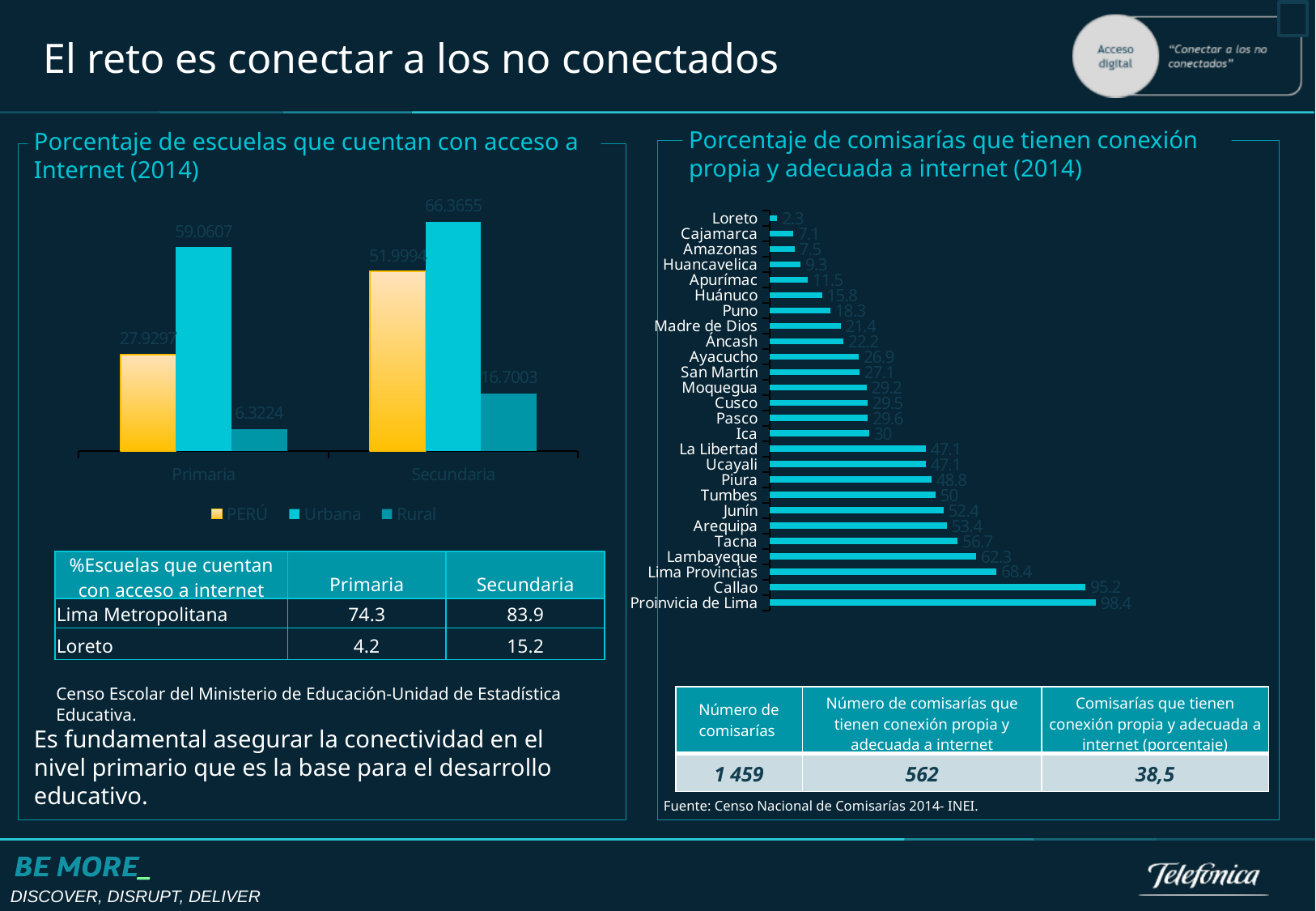
In the chart 'Porcentaje de escuelas que cuentan con acceso a Internet (2014)', what is the value for Urbana in Primaria? 59.0607 In the chart 'Porcentaje de escuelas que cuentan con acceso a Internet (2014)', which series has the lowest value in Secundaria? Rural In the chart 'Porcentaje de escuelas que cuentan con acceso a Internet (2014)', what is the value for Rural in Primaria? 6.3224 In the chart 'Porcentaje de escuelas que cuentan con acceso a Internet (2014)', what is the value for Urbana in Secundaria? 66.3655 In the chart 'Porcentaje de comisarías que tienen conexión propia y adecuada a internet (2014)', what is the difference between the values for Lambayeque and Puno? 44 In the chart 'Porcentaje de comisarías que tienen conexión propia y adecuada a internet (2014)', which is larger, the value for Tacna or the value for Junín? Tacna In the chart 'Porcentaje de escuelas que cuentan con acceso a Internet (2014)', how many series does the legend list? 3 In the chart 'Porcentaje de comisarías que tienen conexión propia y adecuada a internet (2014)', which region has the lowest value? Loreto In the chart 'Porcentaje de comisarías que tienen conexión propia y adecuada a internet (2014)', which region has the highest value? Proinvicia de Lima What kind of chart is 'Porcentaje de comisarías que tienen conexión propia y adecuada a internet (2014)'? Bar chart In the chart 'Porcentaje de comisarías que tienen conexión propia y adecuada a internet (2014)', what is the value for Callao? 95.2 In the chart 'Porcentaje de escuelas que cuentan con acceso a Internet (2014)', what is the difference between the Rural values for Secundaria and Primaria? 10.3779